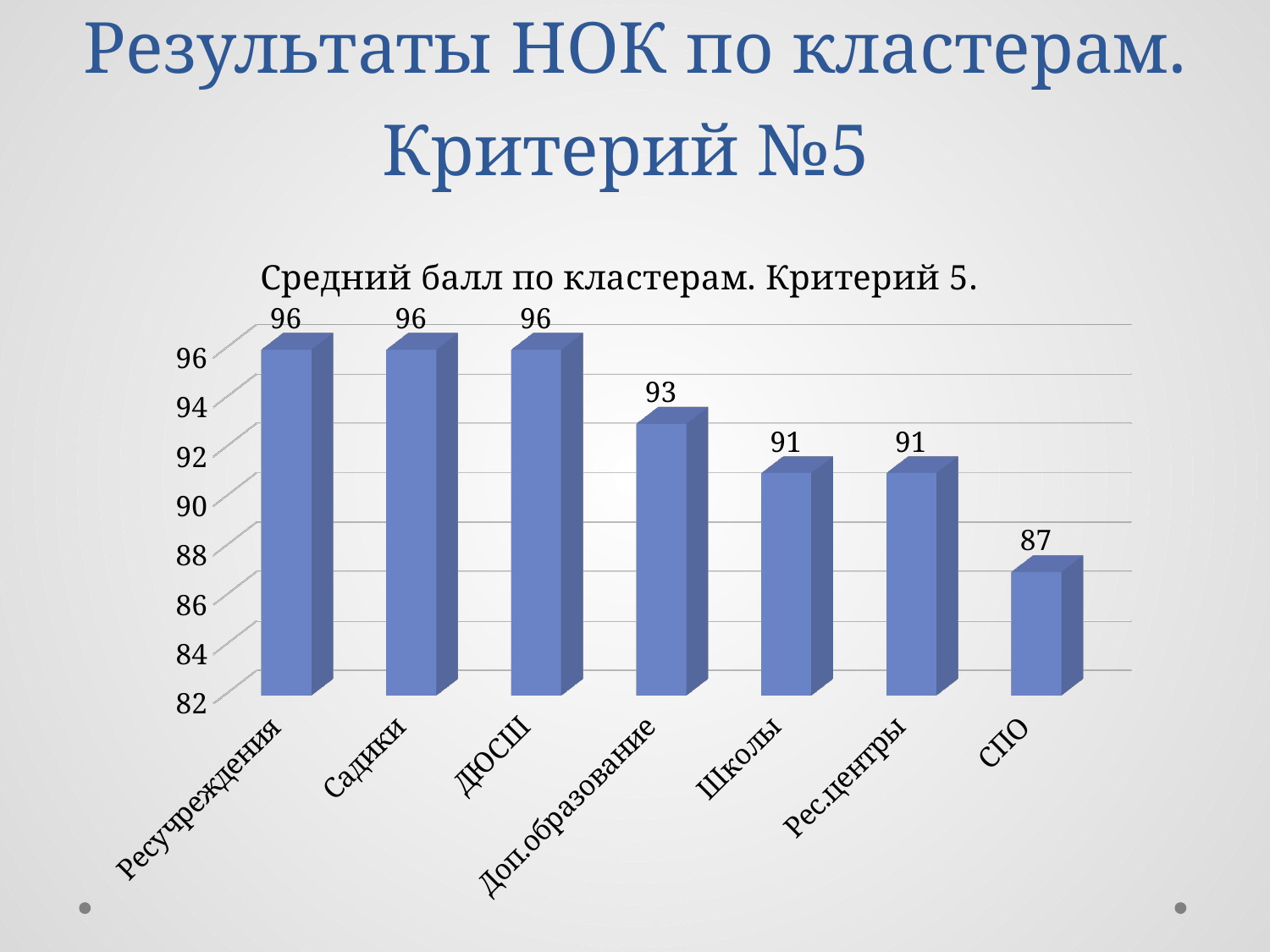
Which category has the lowest value? СПО How many categories are shown on the chart? 7 What is the difference between the values for Ресучреждения and СПО? 9 What is the value for Садики? 96 What is the difference between the values for Доп.образование and Рес.центры? 2 What is the value for СПО? 87 Which is larger, the value for ДЮСШ or the value for Школы? ДЮСШ What is the title of the chart? Средний балл по кластерам. Критерий 5. Do the values rise or fall from left to right along the x axis? Fall What is the value for Школы? 91 What kind of chart is shown on the slide? Bar chart What is the value for Доп.образование? 93